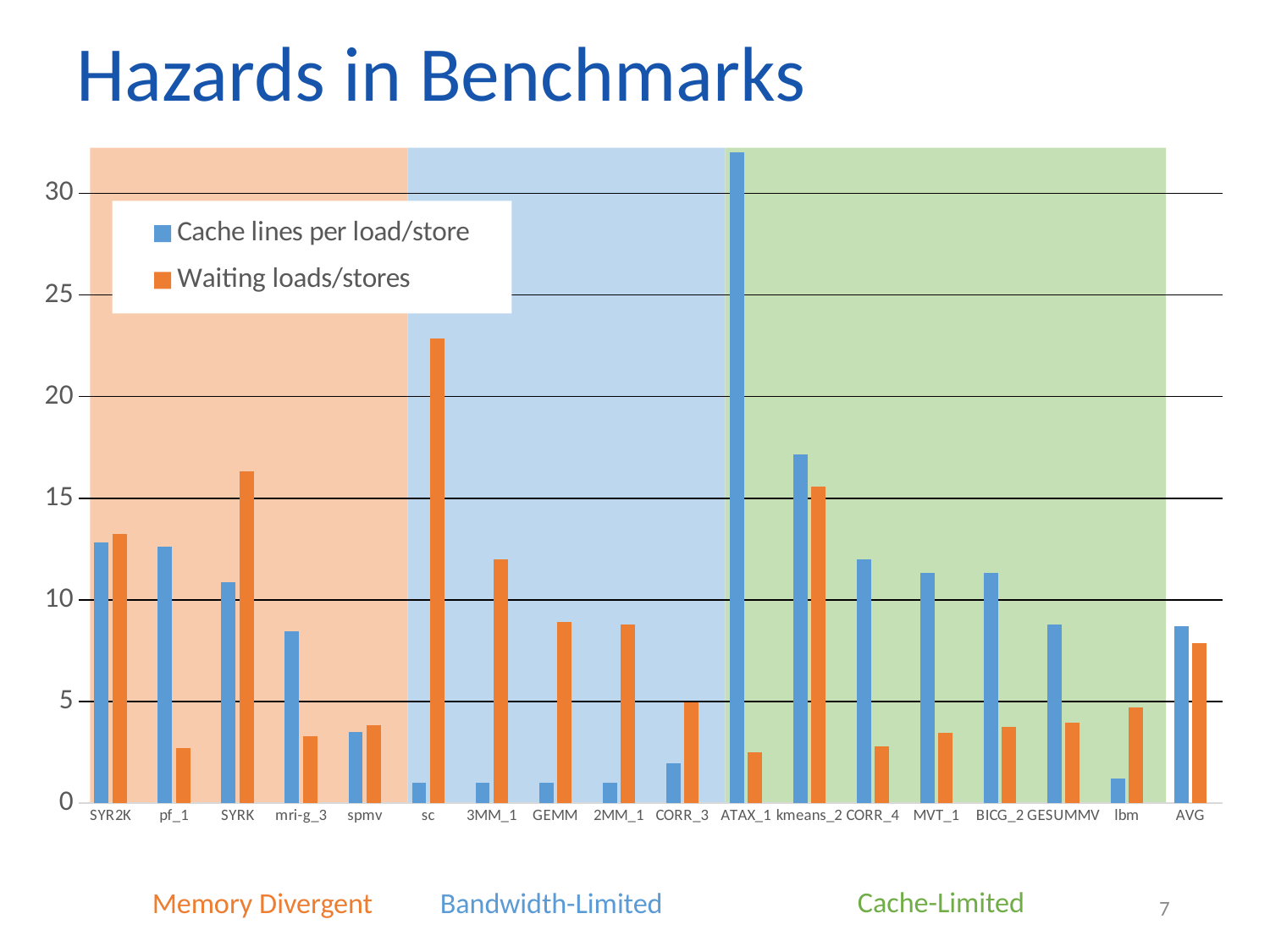
Is the Cache lines per load/store value for CORR_3 greater or less than 5? less Which benchmark has the highest value for Cache lines per load/store? ATAX_1 Is the Cache lines per load/store value for kmeans_2 greater or less than 15? greater For GESUMMV, which is larger: Cache lines per load/store or Waiting loads/stores? Cache lines per load/store Is the Cache lines per load/store value for ATAX_1 greater or less than 30? greater What kind of chart is shown on the slide? bar chart For SYRK, which is larger: Cache lines per load/store or Waiting loads/stores? Waiting loads/stores How many series does the legend list? 2 Which benchmark has the highest value for Waiting loads/stores? sc How many benchmark categories are shown along the x axis, including AVG? 18 Which colour represents the Waiting loads/stores series? orange